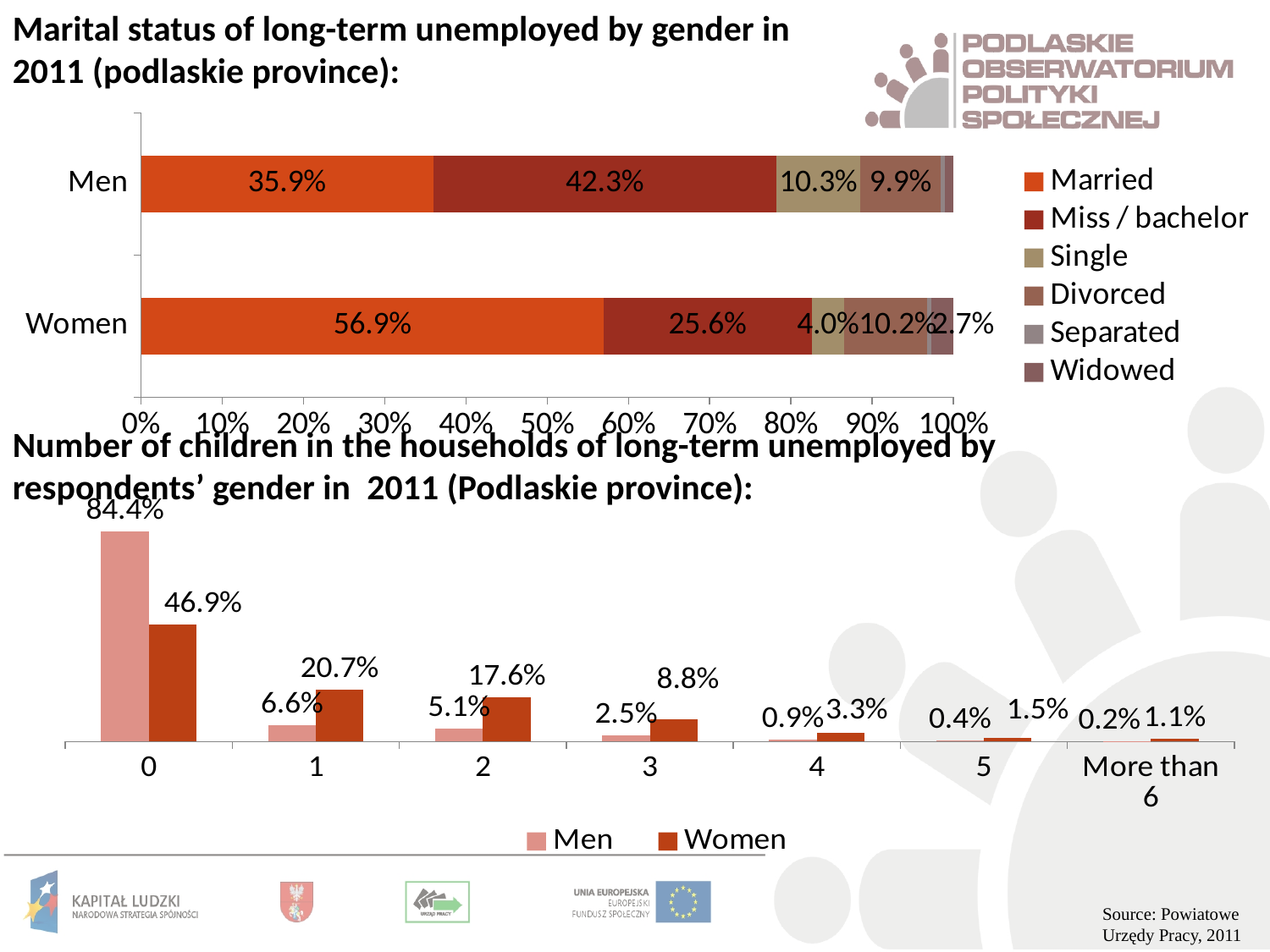
In the marital status chart, how many series does the legend list? 6 What kind of chart is the number of children chart? Bar chart In the marital status chart, what percentage of long-term unemployed women are married? 56.9% In the number of children chart, what percentage of women have 2 children in the household? 17.6% In the number of children chart, how many categories are shown on the x axis? 7 In the marital status chart, which is larger: the Single share for men or the Single share for women? Men In the number of children chart, which category has the lowest value for men? More than 6 In the marital status chart, what is the Miss / bachelor share for men? 42.3% In the number of children chart, what percentage of men have 0 children in the household? 84.4% In the marital status chart, what percentage of long-term unemployed men are married? 35.9% In the marital status chart, what is the difference between the married share for women and the married share for men? 21.0 percentage points In the number of children chart, which category has the highest value for women? 0